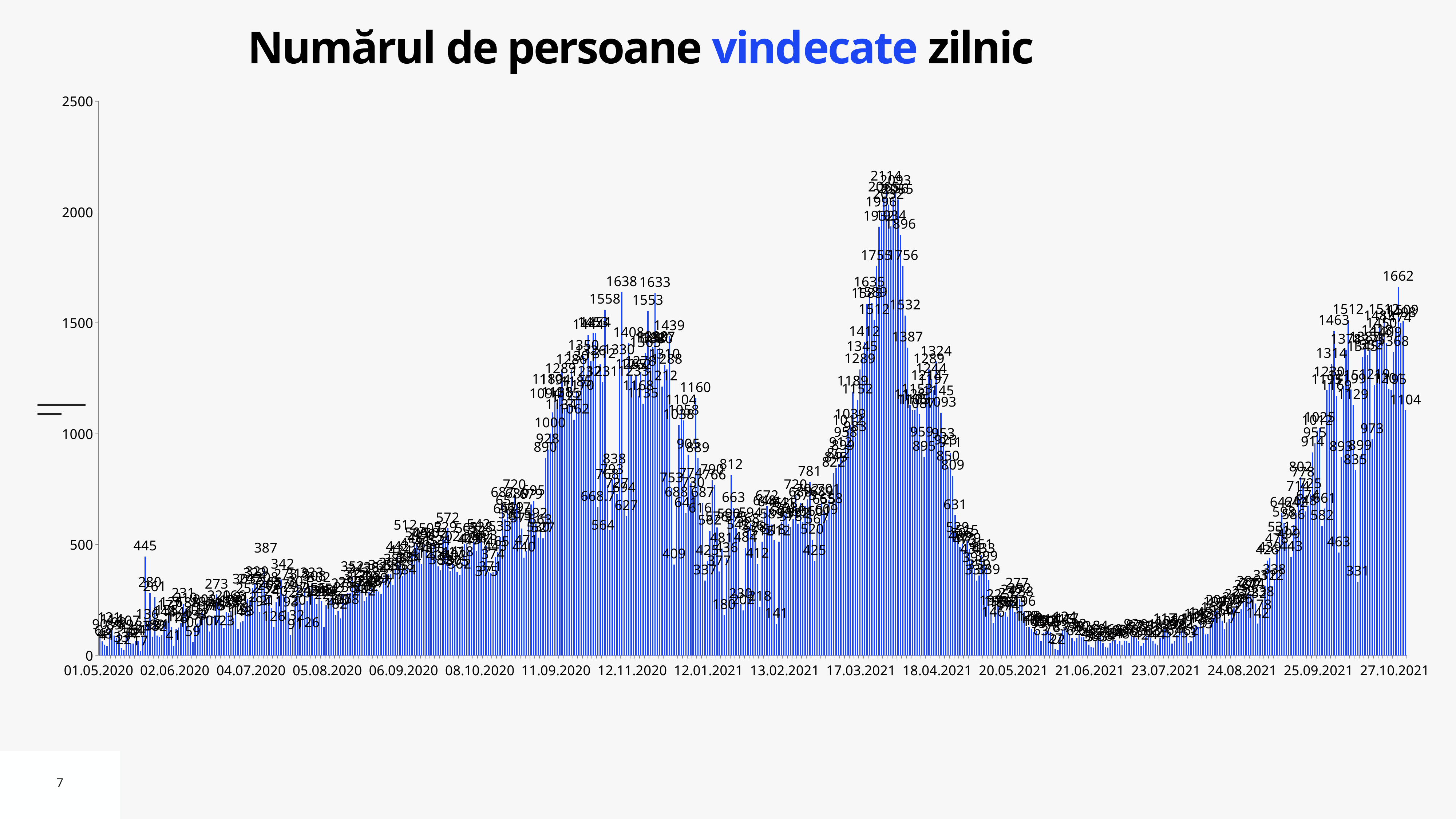
Do the values generally rise or fall between 18.04.2021 and 21.06.2021? fall What is the maximum value shown on the vertical axis? 2500 Which is larger, the early spike labeled 445 or the spike labeled 387? 445 What kind of chart is shown on the slide? bar chart What is the highest data label shown on the chart? 2114 Is the tallest bar on the chart greater or less than 2000? greater What is the difference between the overall peak value 2114 and the late peak value 1662? 452 What is the highest value labeled in the final rise near 27.10.2021? 1662 Is the tallest bar in the November 2020 wave greater or less than 1500? greater What is the first date label on the horizontal axis? 01.05.2020 What is the difference between the spike labeled 445 and the spike labeled 387? 58 What is the title of the chart? Numărul de persoane vindecate zilnic